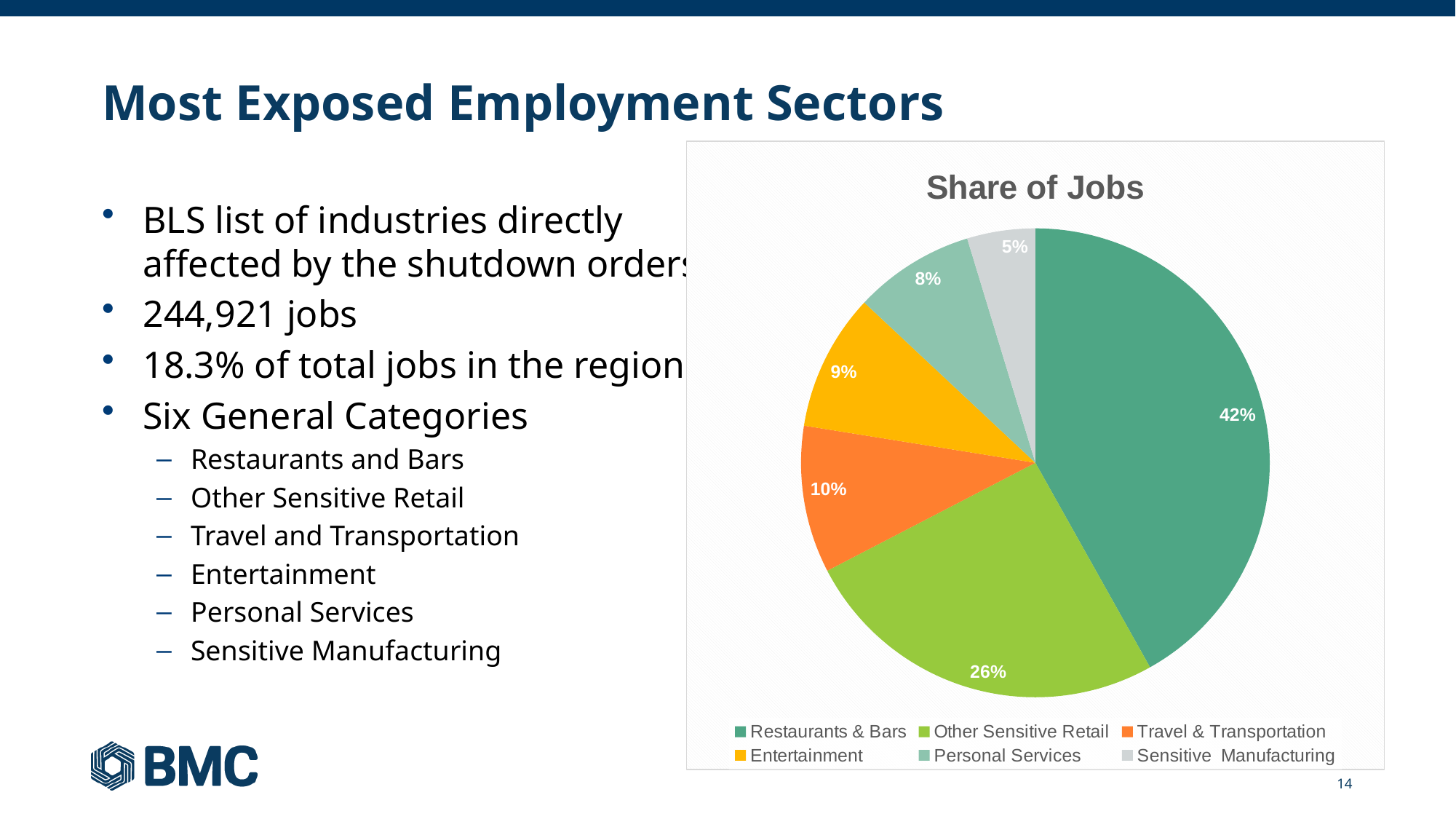
What type of chart is shown on the slide? Pie chart What share of jobs does Entertainment account for? 9% What is the difference in share between Restaurants & Bars and Other Sensitive Retail? 16% What share of jobs does Personal Services account for? 8% What is the title of the chart? Share of Jobs What share of jobs does Travel & Transportation account for? 10% How many categories does the legend list? 6 What share of jobs does Other Sensitive Retail account for? 26% What share of jobs does Sensitive Manufacturing account for? 5% Which category has the smallest share of jobs? Sensitive Manufacturing Which category has the largest share of jobs? Restaurants & Bars What share of jobs does Restaurants & Bars account for? 42%